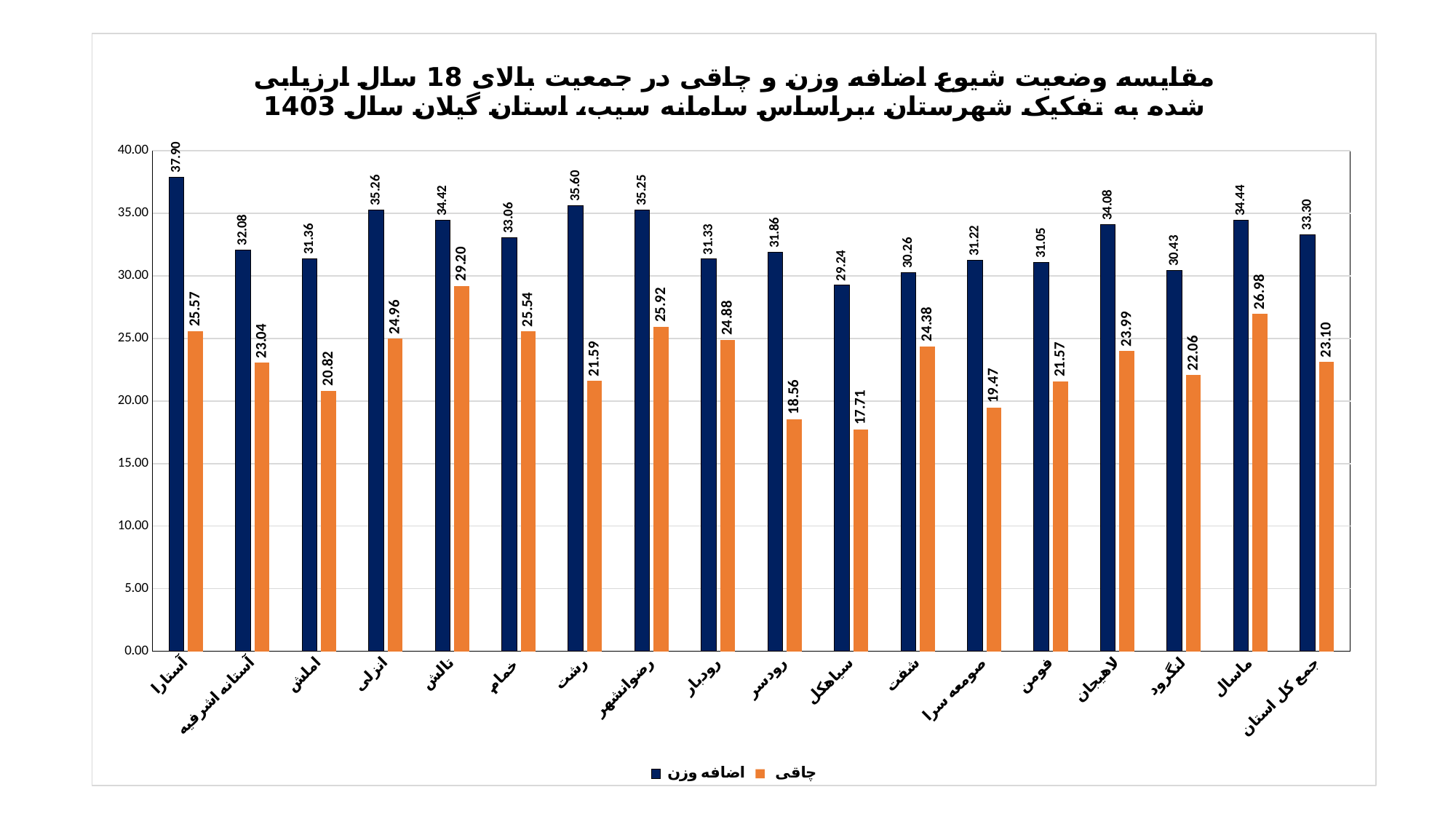
Which category has the highest value for چاقی? تالش Which series is shown in orange in the legend? چاقی What is the value of چاقی for تالش? 29.20 What is the difference between the اضافه وزن and چاقی values for رشت? 14.01 How many series does the legend list? 2 How many categories are shown on the x axis? 18 Which category has the lowest value for چاقی? سیاهکل What is the value of چاقی for جمع کل استان? 23.10 Which is larger, the چاقی value for ماسال or the چاقی value for لاهیجان? ماسال What type of chart is shown on the slide? bar chart What is the value of اضافه وزن for آستارا? 37.90 Which category has the highest value for اضافه وزن? آستارا